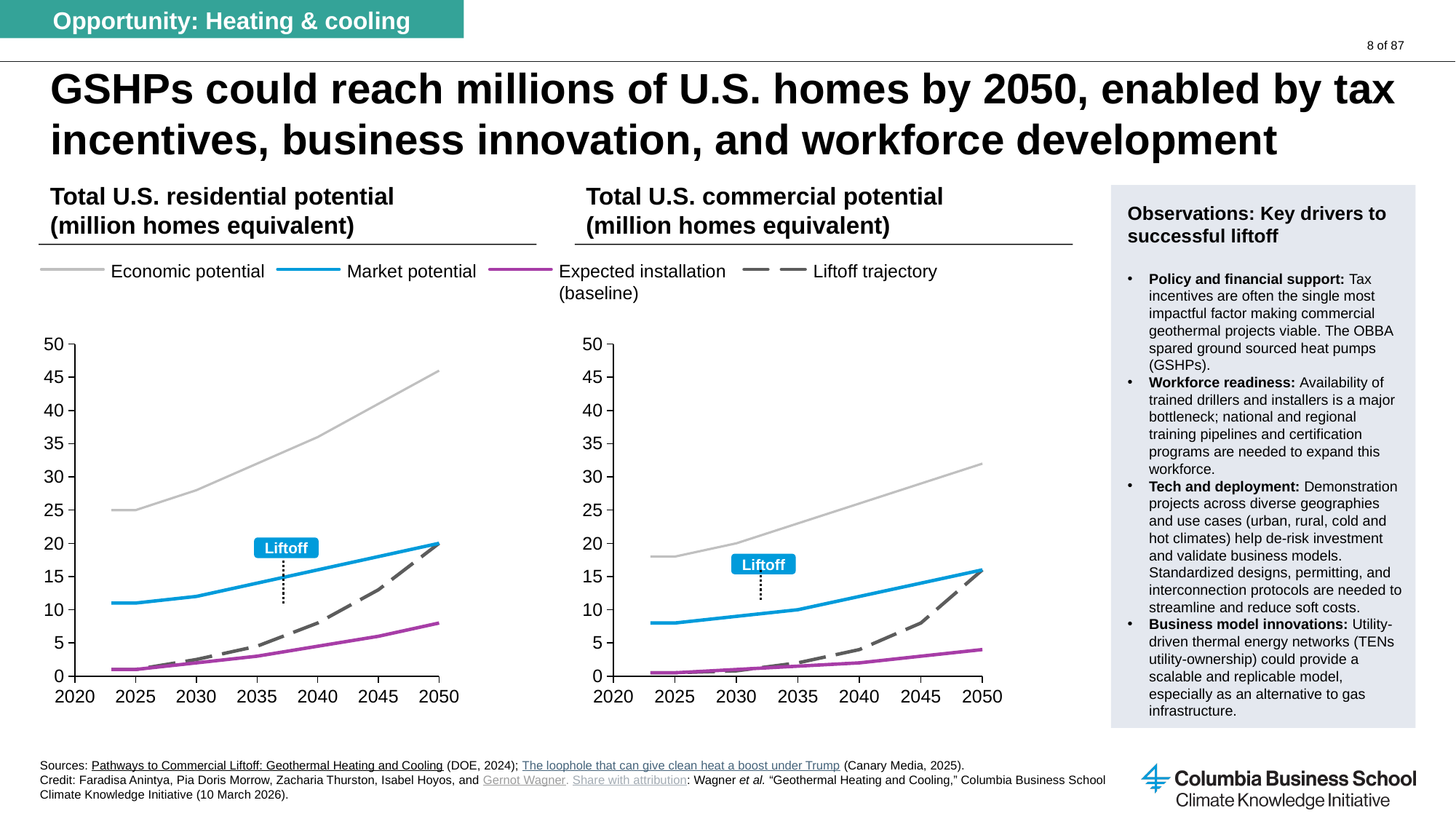
What type of chart is the 'Total U.S. residential potential' chart? line chart In the 'Total U.S. residential potential' chart, is the Expected installation (baseline) value in 2050 greater or less than 10? less In the 'Total U.S. commercial potential' chart, is the Market potential value in 2050 greater or less than 20? less In the 'Total U.S. residential potential' chart, does the Economic potential line rise or fall from 2025 to 2050? rise What are the four series named in the legend? Economic potential, Market potential, Expected installation (baseline), Liftoff trajectory In the 'Total U.S. commercial potential' chart, is the Economic potential value in 2050 greater or less than 35? less How many series does the shared legend list for the two charts? 4 In the 'Total U.S. residential potential' chart, which series has the lowest value in 2050? Expected installation (baseline) What label is attached to the dotted vertical marker in each chart? Liftoff Which is larger in 2050: Economic potential in the residential chart or Economic potential in the commercial chart? residential In the 'Total U.S. residential potential' chart, which series has the highest values across the whole period? Economic potential